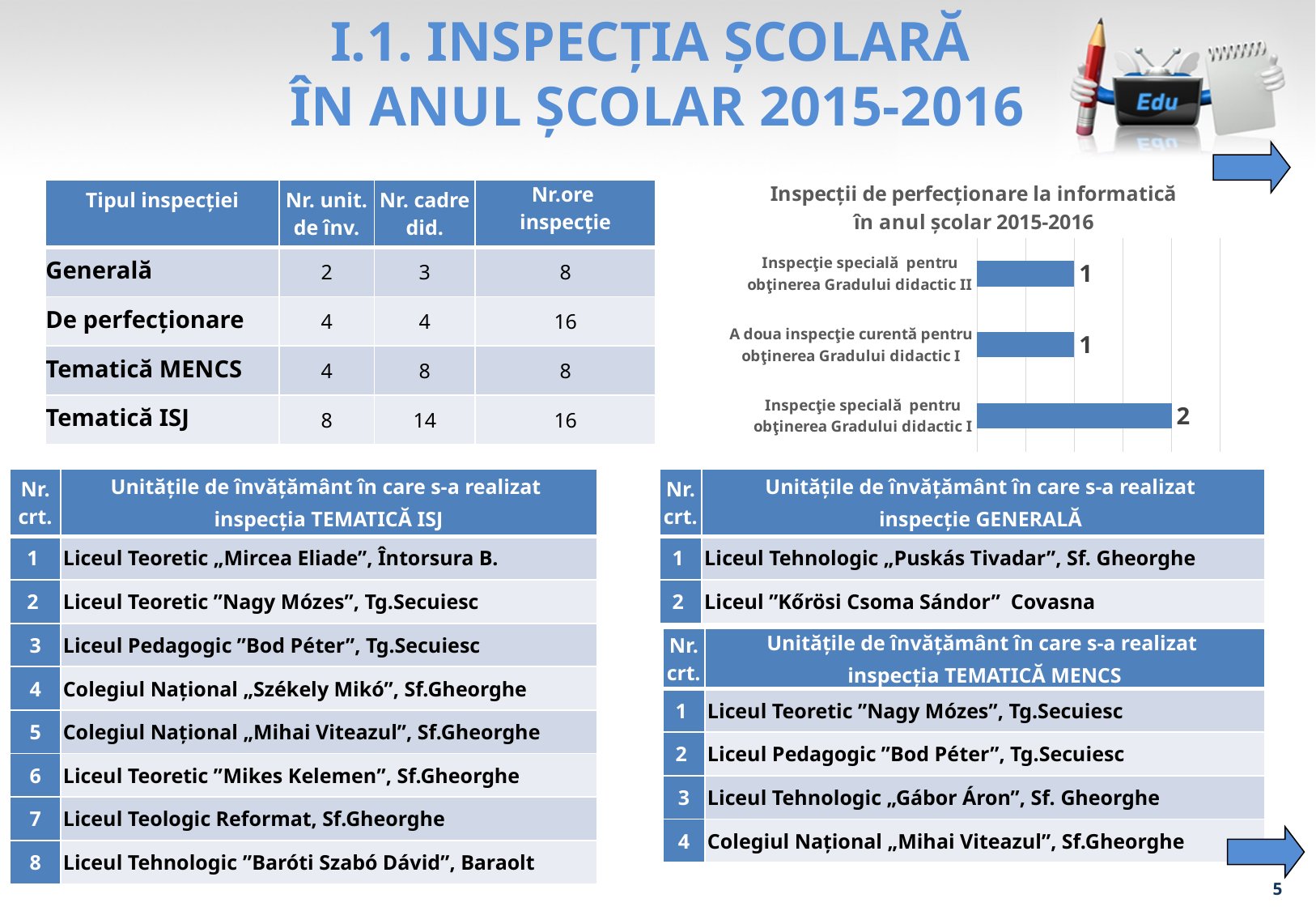
What is the difference between the value for "Inspecţie specială pentru obţinerea Gradului didactic I" and the value for "Inspecţie specială pentru obţinerea Gradului didactic II"? 1 Which category has the highest value in the chart? Inspecţie specială pentru obţinerea Gradului didactic I What is the value for "A doua inspecţie curentă pentru obţinerea Gradului didactic I" in the chart? 1 What is the sum of all three values shown in the chart? 4 What is the title of the chart? Inspecții de perfecționare la informatică în anul școlar 2015-2016 Are the bars in the chart horizontal or vertical? Horizontal What is the value for "Inspecţie specială pentru obţinerea Gradului didactic II" in the chart? 1 What kind of chart is shown on the slide? Bar chart What is the value for "Inspecţie specială pentru obţinerea Gradului didactic I" in the chart? 2 How many categories are shown in the chart? 3 Which is larger: the value for "Inspecţie specială pentru obţinerea Gradului didactic I" or the value for "A doua inspecţie curentă pentru obţinerea Gradului didactic I"? Inspecţie specială pentru obţinerea Gradului didactic I